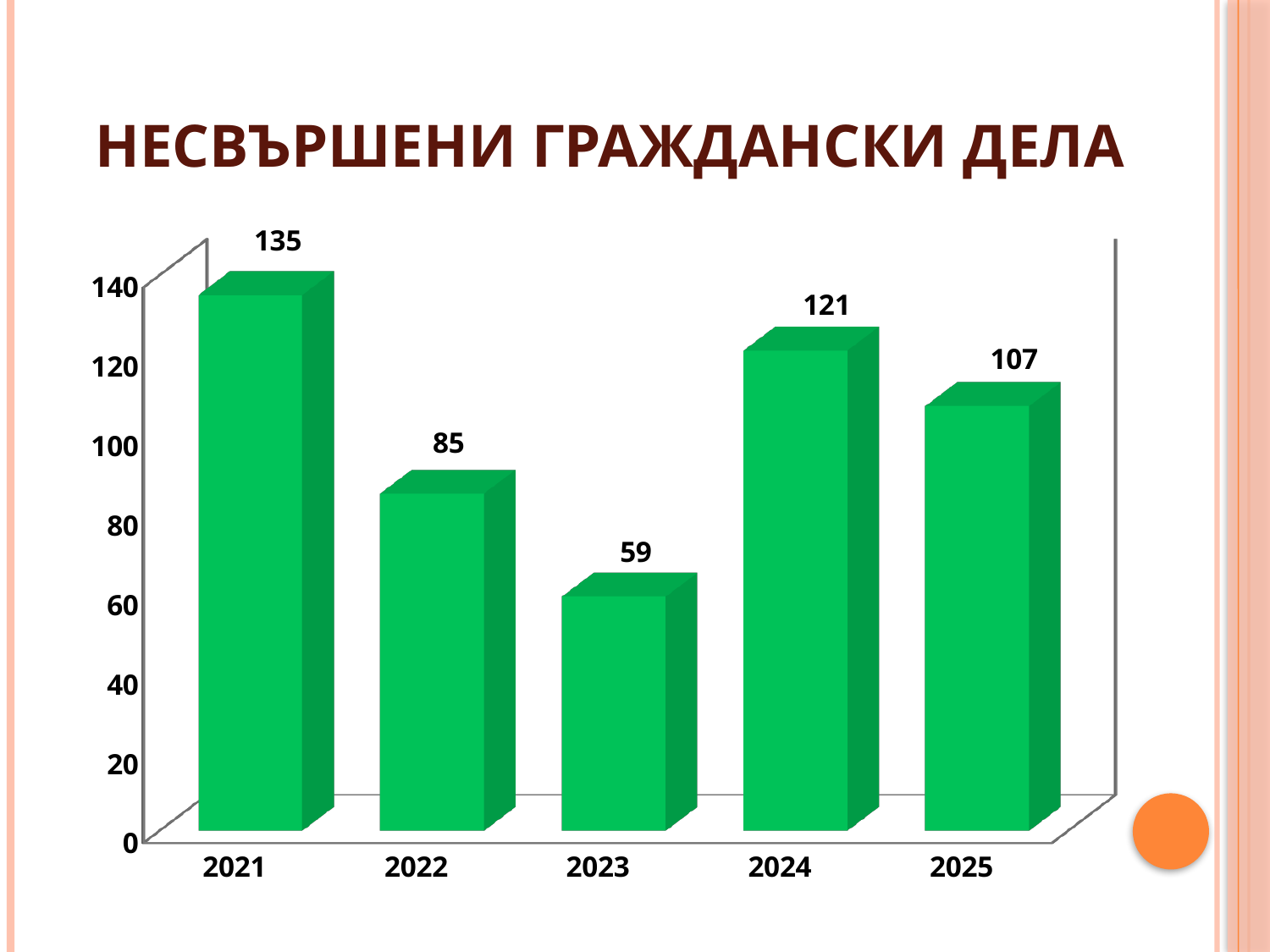
What is the value for 2025? 107 Is the value for 2022 greater or less than 100? less What kind of chart is shown on the slide? bar chart What is the value for 2021? 135 Which year has the lowest value? 2023 What is the value for 2023? 59 Which year has the highest value? 2021 What is the difference between the values for 2021 and 2022? 50 What is the difference between the values for 2024 and 2025? 14 Which is larger, the value for 2022 or the value for 2024? 2024 What is the title of the chart? НЕСВЪРШЕНИ ГРАЖДАНСКИ ДЕЛА How many years are shown on the x axis? 5